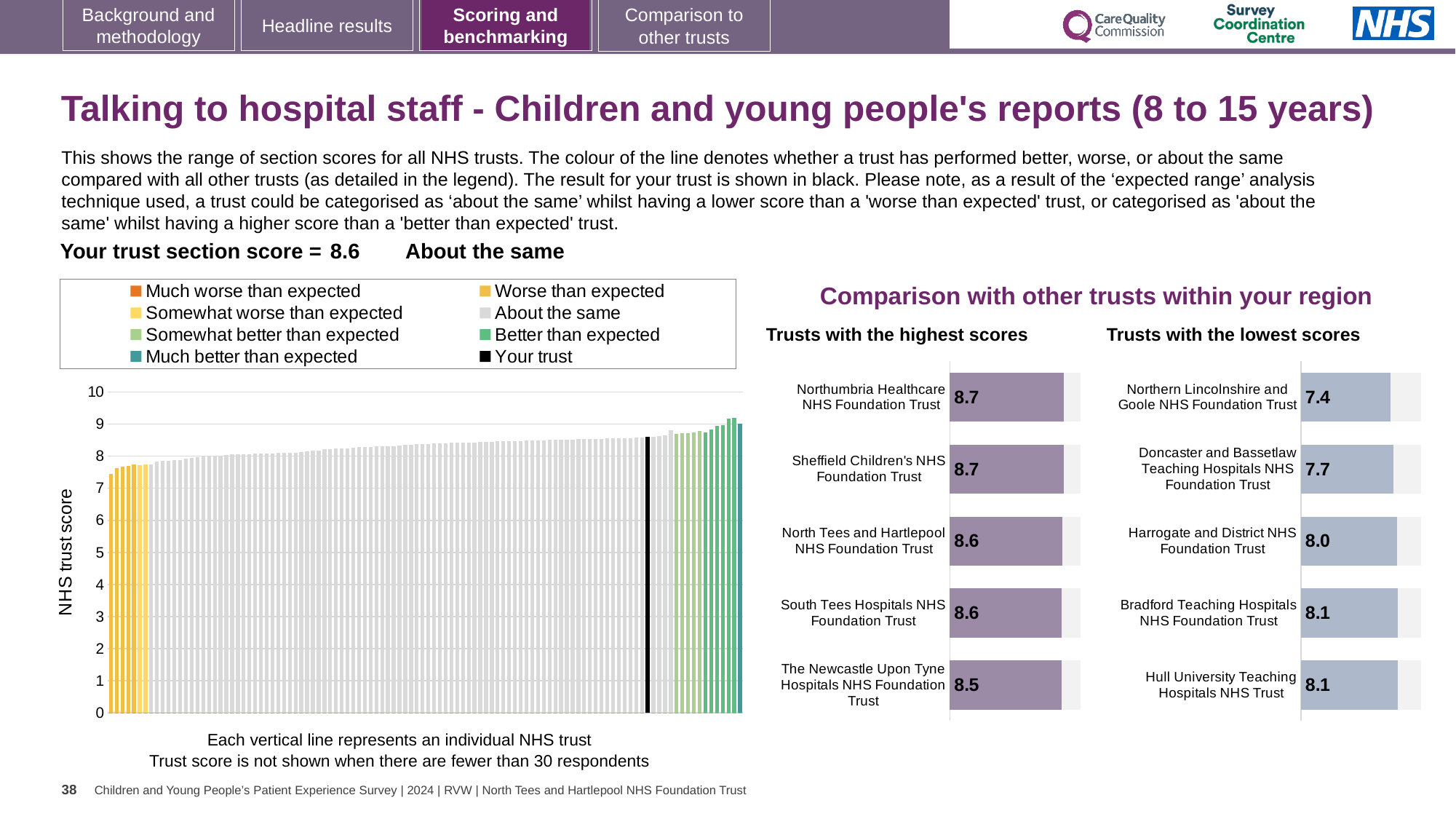
In the 'Trusts with the lowest scores' chart, what is the score for Doncaster and Bassetlaw Teaching Hospitals NHS Foundation Trust? 7.7 In the 'Trusts with the lowest scores' chart, which has the higher score: Doncaster and Bassetlaw Teaching Hospitals NHS Foundation Trust or Harrogate and District NHS Foundation Trust? Harrogate and District NHS Foundation Trust In the 'Trusts with the highest scores' chart, what is the score for The Newcastle Upon Tyne Hospitals NHS Foundation Trust? 8.5 In the large chart on the left, is the value of the black 'Your trust' bar greater or less than 8? greater In the 'Trusts with the highest scores' chart, what is the difference between the scores of Northumbria Healthcare NHS Foundation Trust and The Newcastle Upon Tyne Hospitals NHS Foundation Trust? 0.2 In the 'Trusts with the highest scores' chart, what is the score for Northumbria Healthcare NHS Foundation Trust? 8.7 In the 'Trusts with the lowest scores' chart, what is the difference between the scores of Hull University Teaching Hospitals NHS Trust and Northern Lincolnshire and Goole NHS Foundation Trust? 0.7 What kind of chart is the large chart on the left showing NHS trust scores? Bar chart How many entries does the legend of the large chart on the left list? 8 How many trusts are listed in the 'Trusts with the highest scores' chart? 5 In the large chart on the left, do the bar values rise or fall from left to right along the x axis? Rise In the 'Trusts with the lowest scores' chart, which trust has the lowest score? Northern Lincolnshire and Goole NHS Foundation Trust